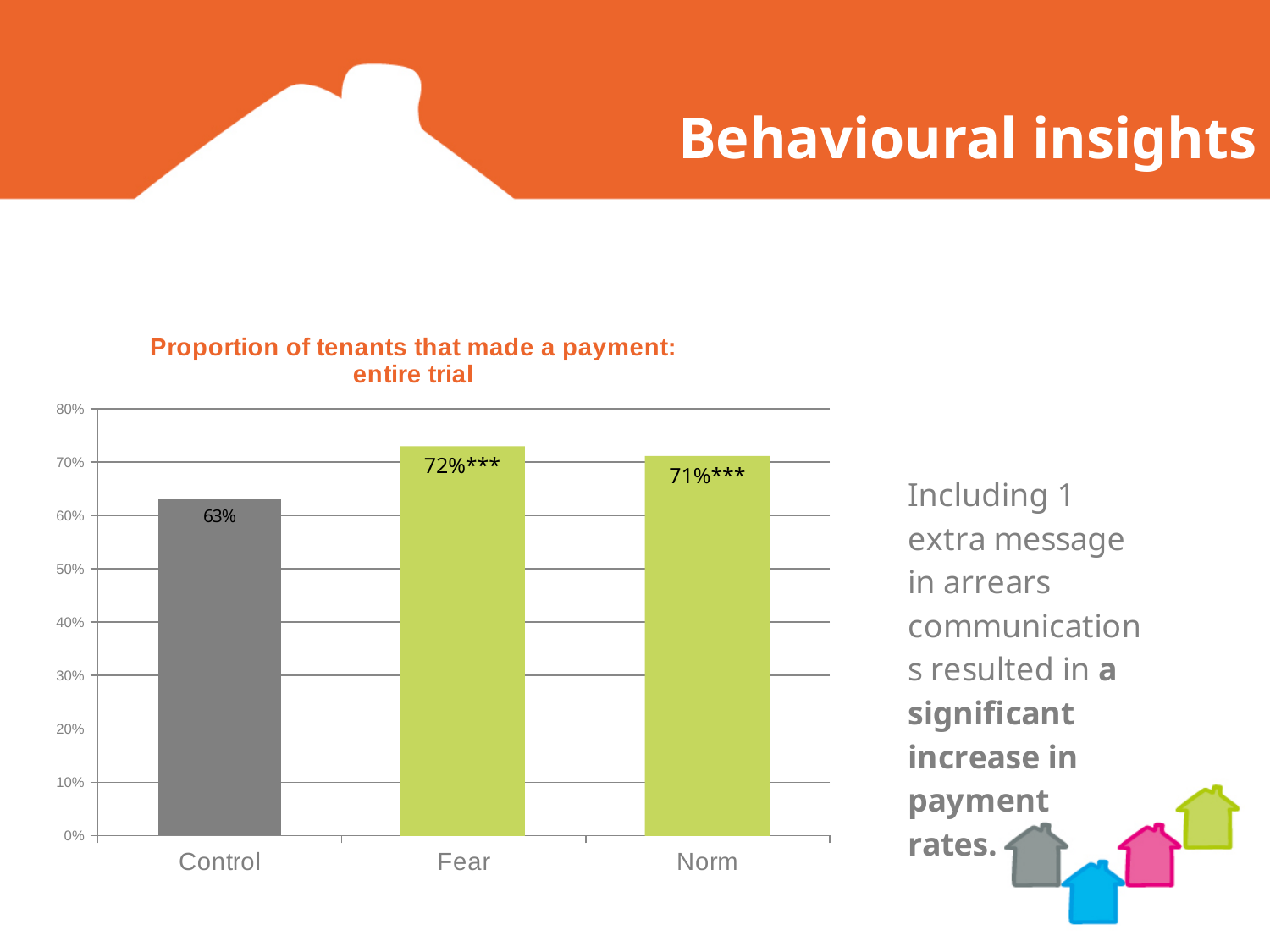
How many categories are shown on the x axis? 3 What is the value for Control? 63% Which category has the lowest value? Control What kind of chart is shown on the slide? bar chart What is the value for Fear? 72% What is the value for Norm? 71% Which is larger, the value for Norm or the value for Control? Norm What is the difference between the values for Fear and Control? 9% Which category has the highest value? Fear What colour is the Control bar? grey Is the value for Control greater or less than 70%? less What is the title of the chart? Proportion of tenants that made a payment: entire trial